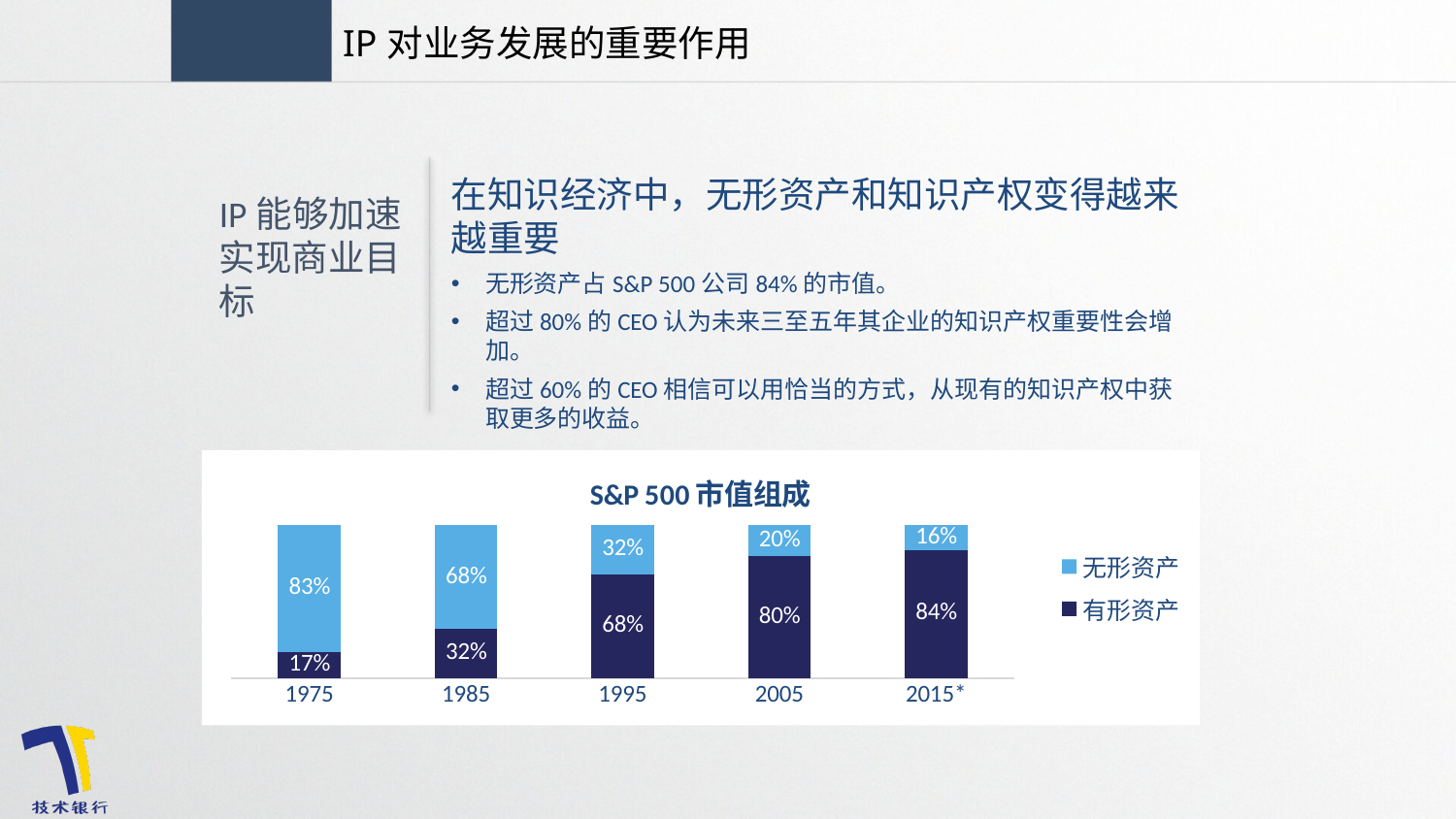
How many years are shown on the x axis of the chart? 5 Which year has the lowest value for 有形资产? 1975 Does the value for 有形资产 rise or fall from 1975 to 2015*? Rise What is the value of 有形资产 for 1985? 32% What is the value of 无形资产 for 1975 in the S&P 500 市值组成 chart? 83% What is the value of 无形资产 for 1995? 32% In 1985, which is larger: 无形资产 or 有形资产? 无形资产 What kind of chart is shown on the slide? Stacked bar chart Which year has the highest value for 有形资产? 2015* What is the value of 有形资产 for 2015* in the S&P 500 市值组成 chart? 84% How many series does the legend list? 2 What is the difference between 有形资产 and 无形资产 in 2005? 60%